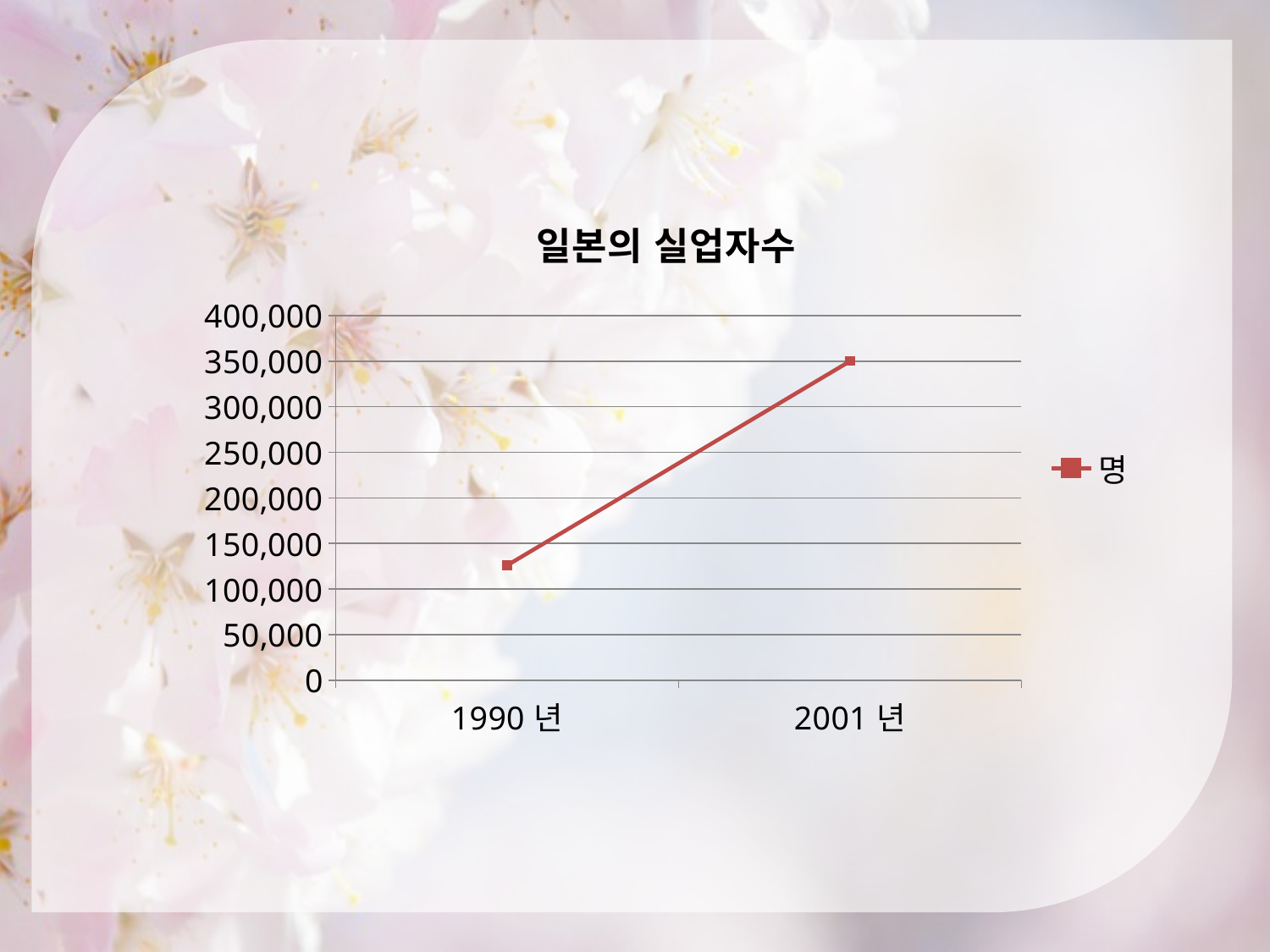
How many series does the legend list? 1 Do the values rise or fall from 1990 년 to 2001 년? rise How many data points are plotted on the line? 2 Which year has the highest value? 2001 년 What is the name of the series listed in the legend? 명 Is the value for 1990 년 greater or less than 150,000? less What is the title of the chart? 일본의 실업자수 What kind of chart is shown on the slide? line chart What is the value for 2001 년? 350,000 Is the value for 1990 년 greater or less than 100,000? greater Which year has the lowest value? 1990 년 Is the value for 2001 년 greater or less than 300,000? greater